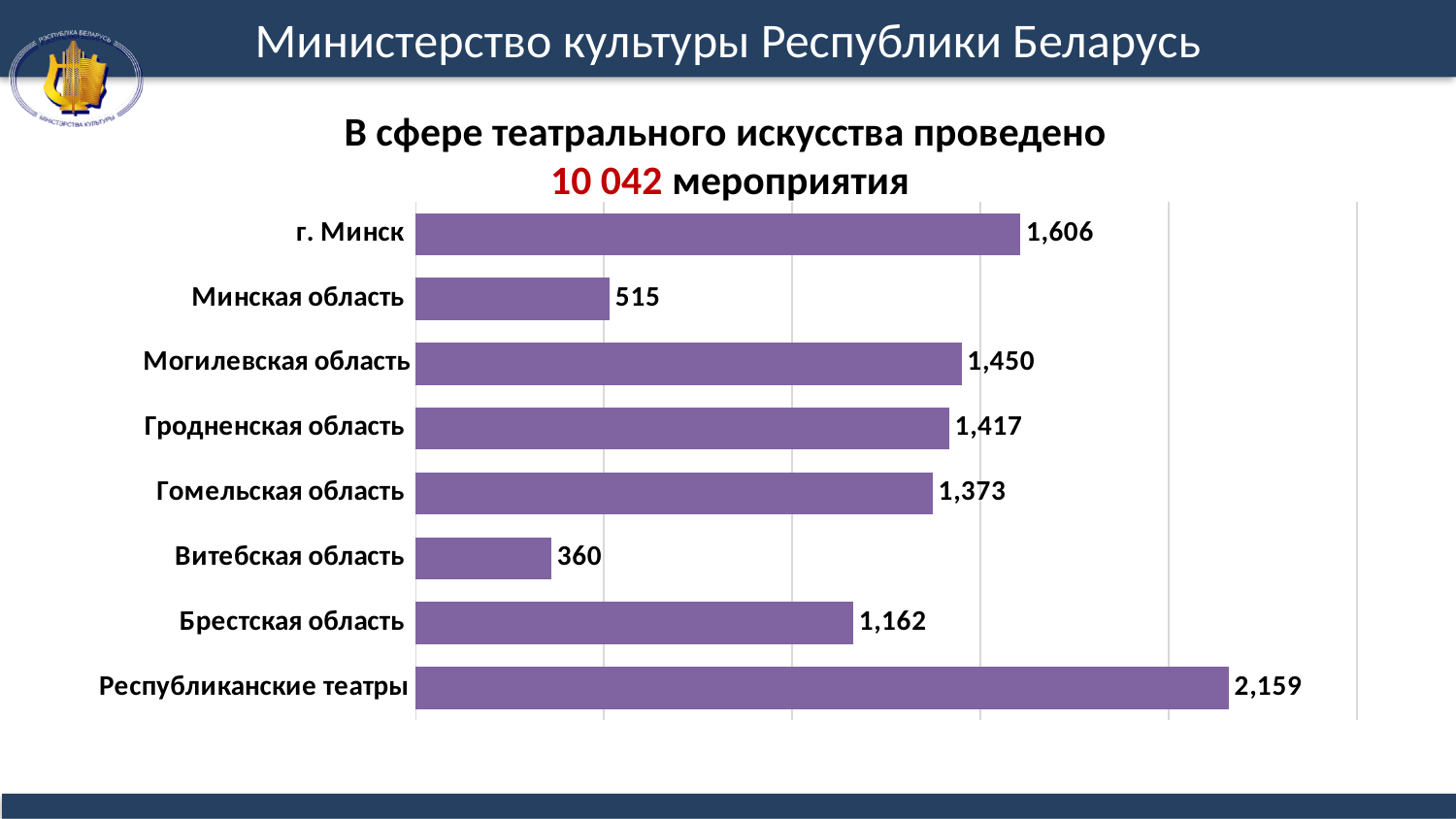
Which is larger, the value for Могилевская область or the value for Гомельская область? Могилевская область How many categories are shown in the chart? 8 Which category has the highest value? Республиканские театры What total number of events is stated in the chart title? 10 042 What is the value for Витебская область? 360 What kind of chart is shown on the slide? Bar chart What is the difference between the values for Минская область and Витебская область? 155 Which category has the lowest value? Витебская область What is the value for Брестская область? 1,162 What is the value for г. Минск? 1,606 What is the difference between the values for Республиканские театры and г. Минск? 553 What is the value for Республиканские театры? 2,159